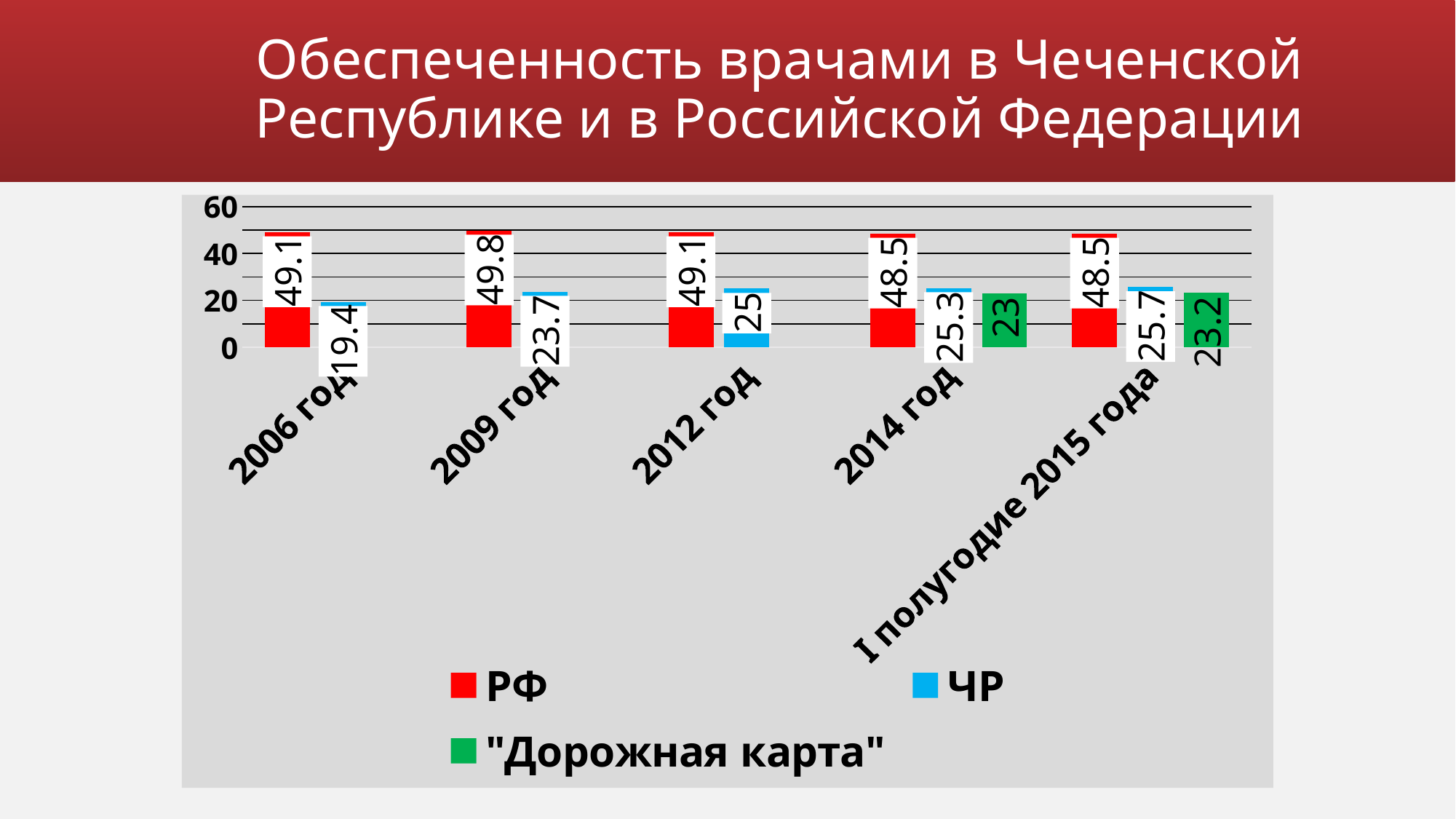
In which category is the РФ value highest? 2009 год In which category is the ЧР value lowest? 2006 год What is the value for "Дорожная карта" in I полугодие 2015 года? 23.2 How many categories are shown on the x axis? 5 Do the ЧР values rise or fall from 2006 год to I полугодие 2015 года? rise What is the value for РФ in 2006 год? 49.1 What is the value for ЧР in 2012 год? 25 What kind of chart is shown on the slide? bar chart What is the value for ЧР in 2009 год? 23.7 How many series does the legend list? 3 What is the difference between the РФ and ЧР values in 2014 год? 23.2 Which is larger in I полугодие 2015 года: the ЧР value or the "Дорожная карта" value? ЧР